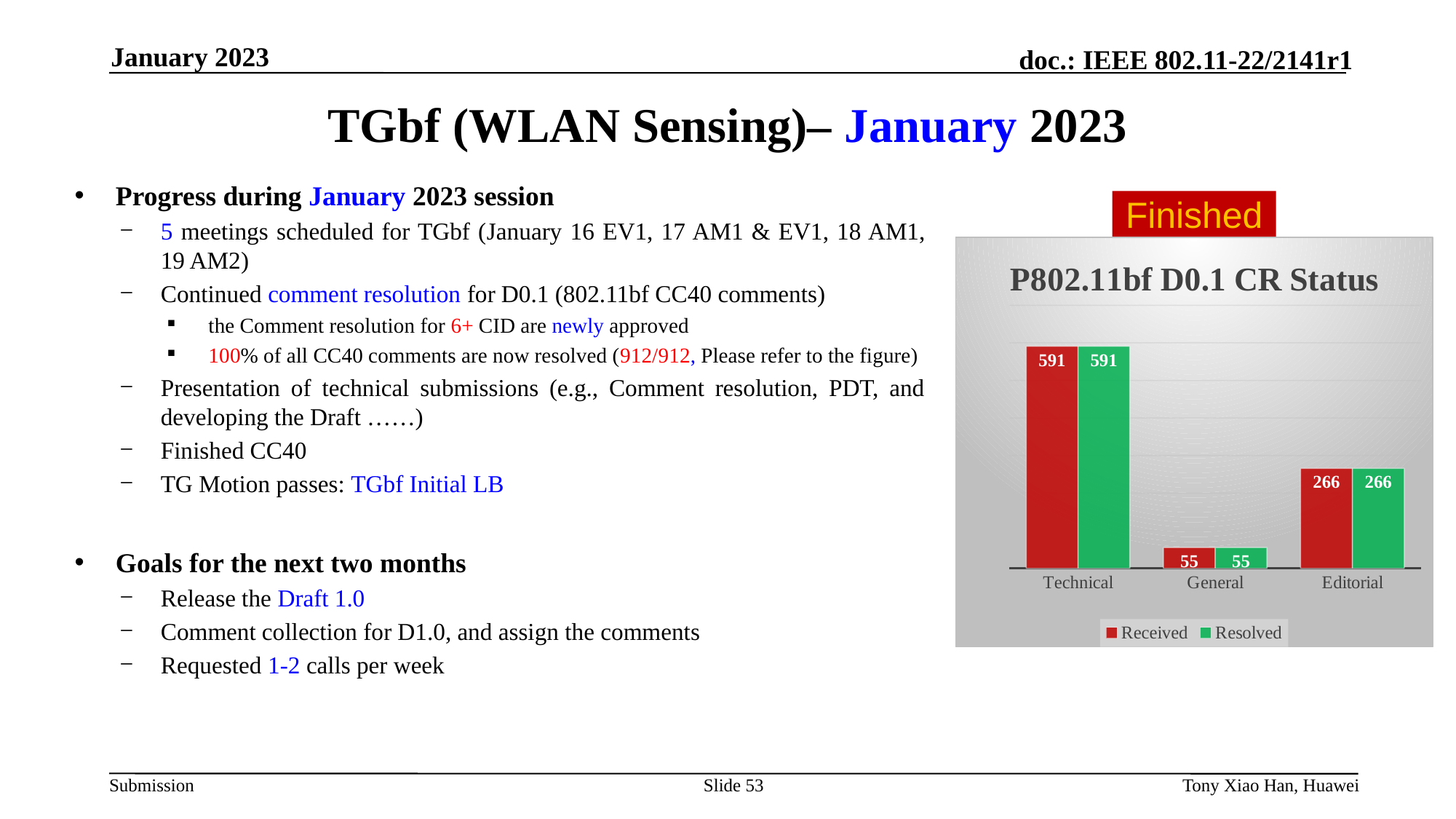
What is the Resolved value for General? 55 What is the Received value for Editorial? 266 How many categories are shown on the x axis? 3 What kind of chart is shown? Bar chart Which is larger, the Received value for General or the Received value for Editorial? Editorial What is the title of the chart? P802.11bf D0.1 CR Status What is the difference between the Received values for Technical and Editorial? 325 What is the Received value for Technical? 591 Which category has the lowest Resolved value? General What is the difference between the Resolved values for Editorial and General? 211 How many series does the legend list? 2 Which category has the highest Received value? Technical